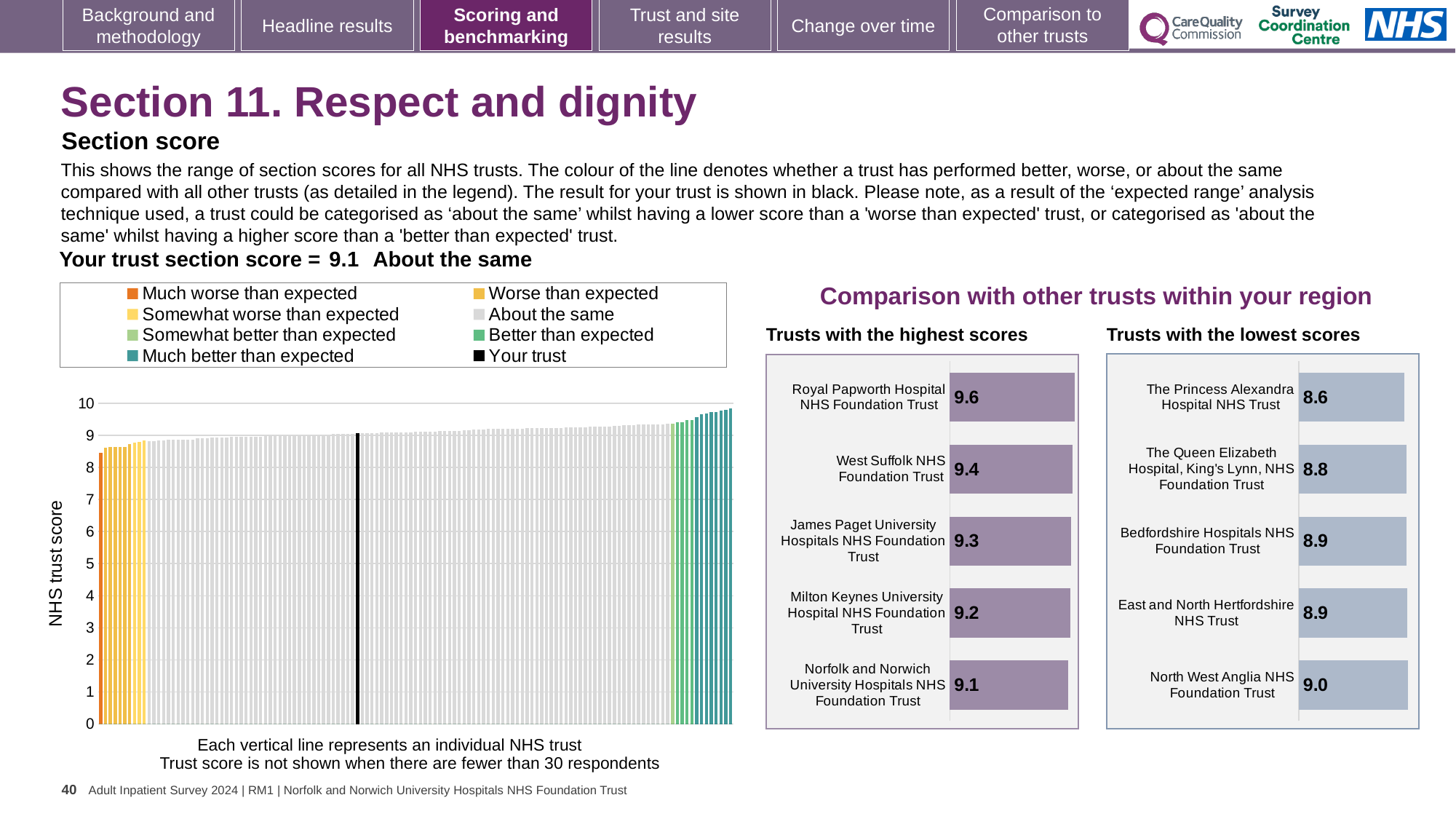
How many entries does the legend of the large chart on the left list? 8 In the 'Trusts with the lowest scores' chart, what is the score for The Princess Alexandra Hospital NHS Trust? 8.6 In the 'Trusts with the highest scores' chart, what is the score for James Paget University Hospitals NHS Foundation Trust? 9.3 In the 'Trusts with the lowest scores' chart, which has the larger score: The Queen Elizabeth Hospital, King's Lynn, NHS Foundation Trust or Bedfordshire Hospitals NHS Trust? Bedfordshire Hospitals NHS Foundation Trust In the 'Trusts with the highest scores' chart, which trust has the highest score? Royal Papworth Hospital NHS Foundation Trust In the 'Trusts with the lowest scores' chart, which trust has the lowest score? The Princess Alexandra Hospital NHS Trust In the 'Trusts with the highest scores' chart, what is the difference between the scores of Royal Papworth Hospital NHS Foundation Trust and Norfolk and Norwich University Hospitals NHS Foundation Trust? 0.5 What is the y-axis label of the large chart on the left? NHS trust score What kind of chart is the large chart on the left showing NHS trust scores? Bar chart In the 'Trusts with the highest scores' chart, how many trusts are shown? 5 In the 'Trusts with the highest scores' chart, what is the score for Royal Papworth Hospital NHS Foundation Trust? 9.6 In the 'Trusts with the lowest scores' chart, what is the difference between the scores of North West Anglia NHS Foundation Trust and The Princess Alexandra Hospital NHS Trust? 0.4